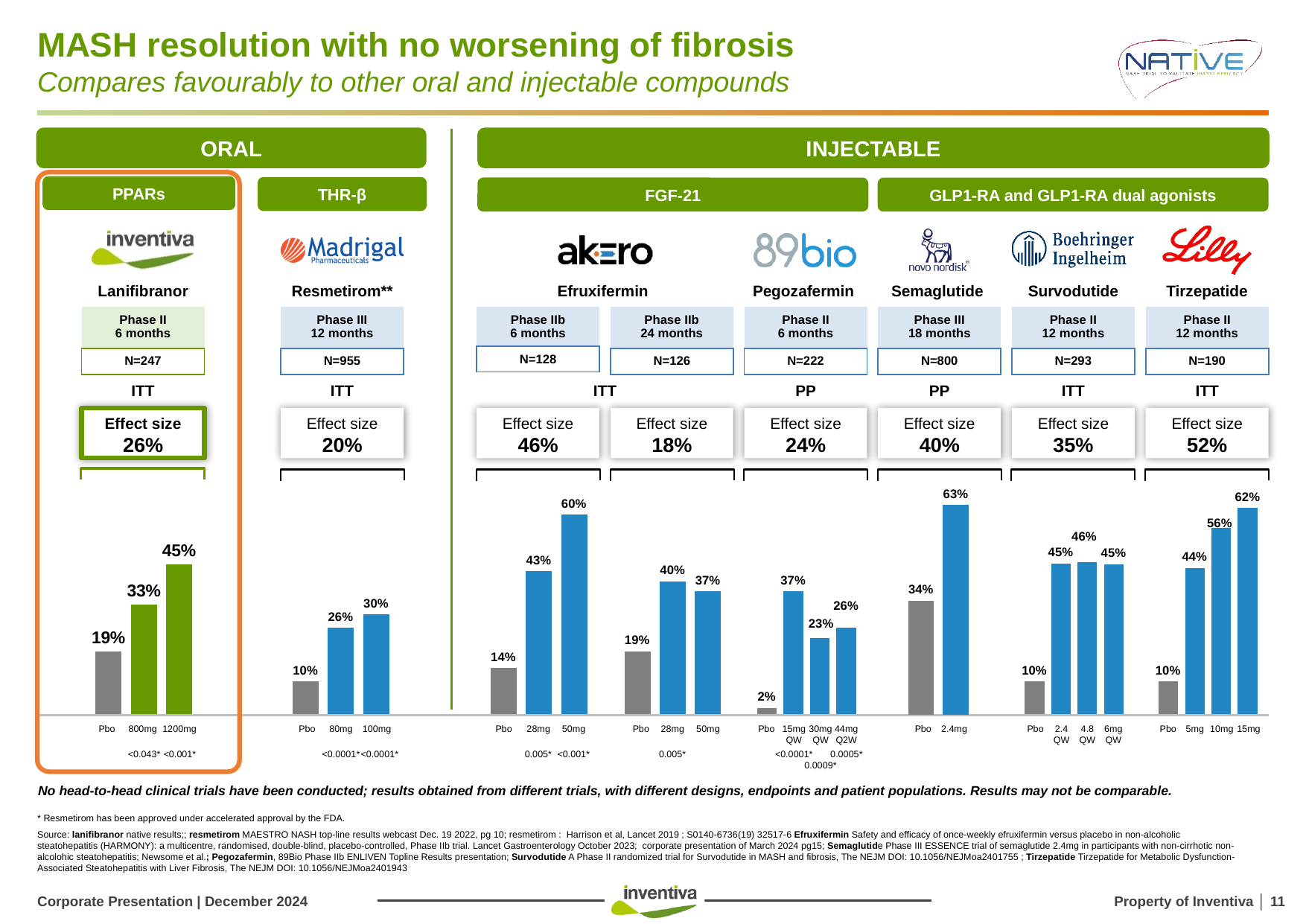
In the Efruxifermin Phase IIb 6 months chart, which dose has the highest value? 50mg In the Resmetirom chart, what is the value for the 100mg bar? 30% In the Lanifibranor chart, what is the value for the Pbo bar? 19% In the Survodutide chart, what is the value for the 4.8 QW bar? 46% In the Lanifibranor chart, what is the value for the 1200mg bar? 45% In the Semaglutide chart, what is the value for the 2.4mg bar? 63% In the Tirzepatide chart, how many bars are plotted? 4 In the Lanifibranor chart, do the values rise or fall from Pbo to 1200mg? rise In the Tirzepatide chart, is the 15mg bar larger or smaller than the 10mg bar? larger In the Pegozafermin chart, which bar has the lowest value? Pbo In the Efruxifermin Phase IIb 24 months chart, what is the difference between the 28mg and Pbo bars? 21% What type of chart is used to show the MASH resolution results for each compound? bar chart